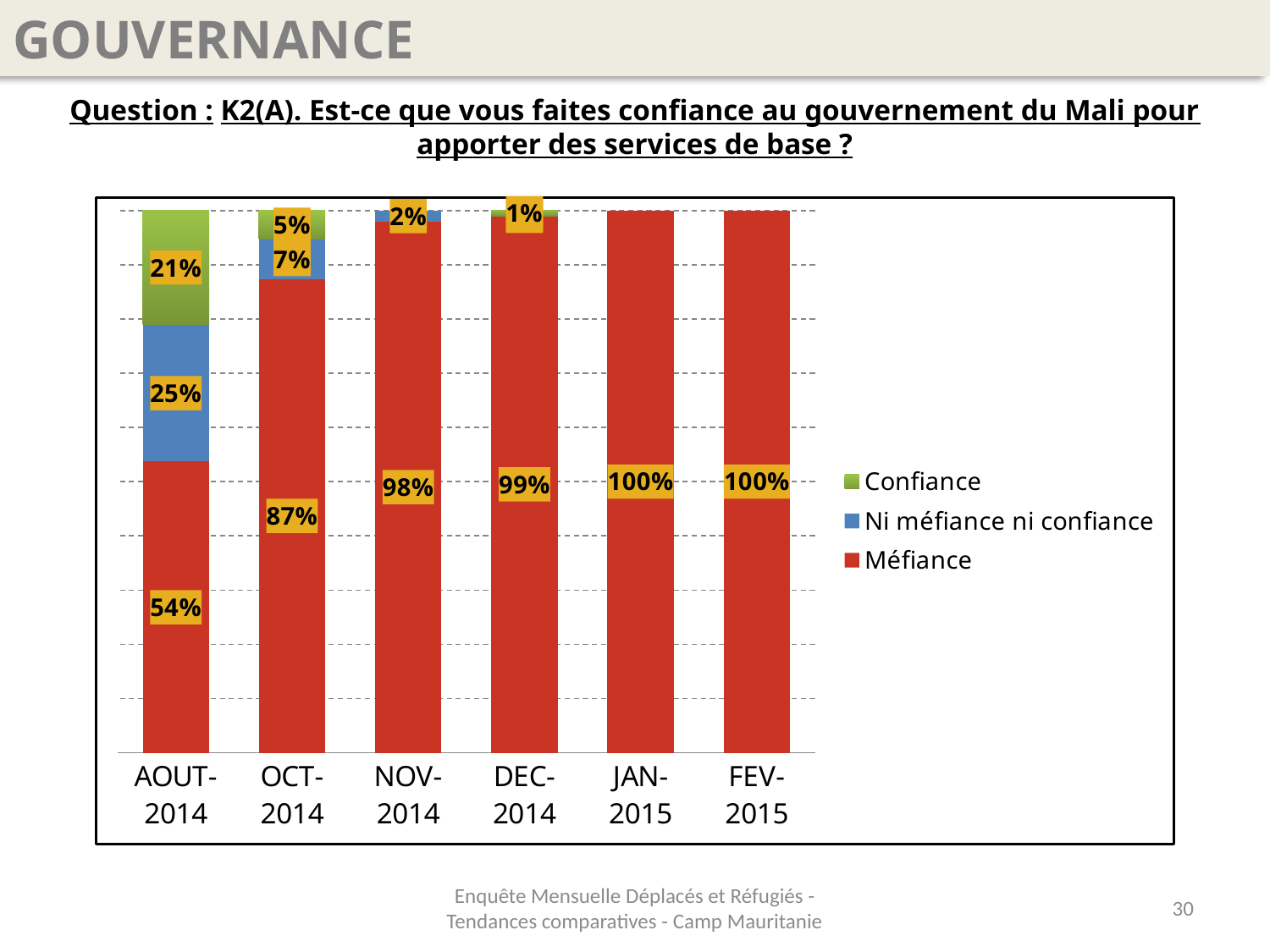
What is the Méfiance value for JAN-2015? 100% What type of chart is shown on the slide? Stacked bar chart What is the Confiance value for AOUT-2014? 21% What is the Méfiance value for NOV-2014? 98% What is the Méfiance value for AOUT-2014? 54% How many series does the legend list? 3 How many time periods are shown on the x axis? 6 Which is larger, the Ni méfiance ni confiance value for AOUT-2014 or the Confiance value for AOUT-2014? Ni méfiance ni confiance Does the Méfiance value rise or fall from AOUT-2014 to FEV-2015? Rise What is the difference between the Méfiance value for OCT-2014 and AOUT-2014? 33% In which period is the Méfiance value lowest? AOUT-2014 What is the Ni méfiance ni confiance value for OCT-2014? 7%